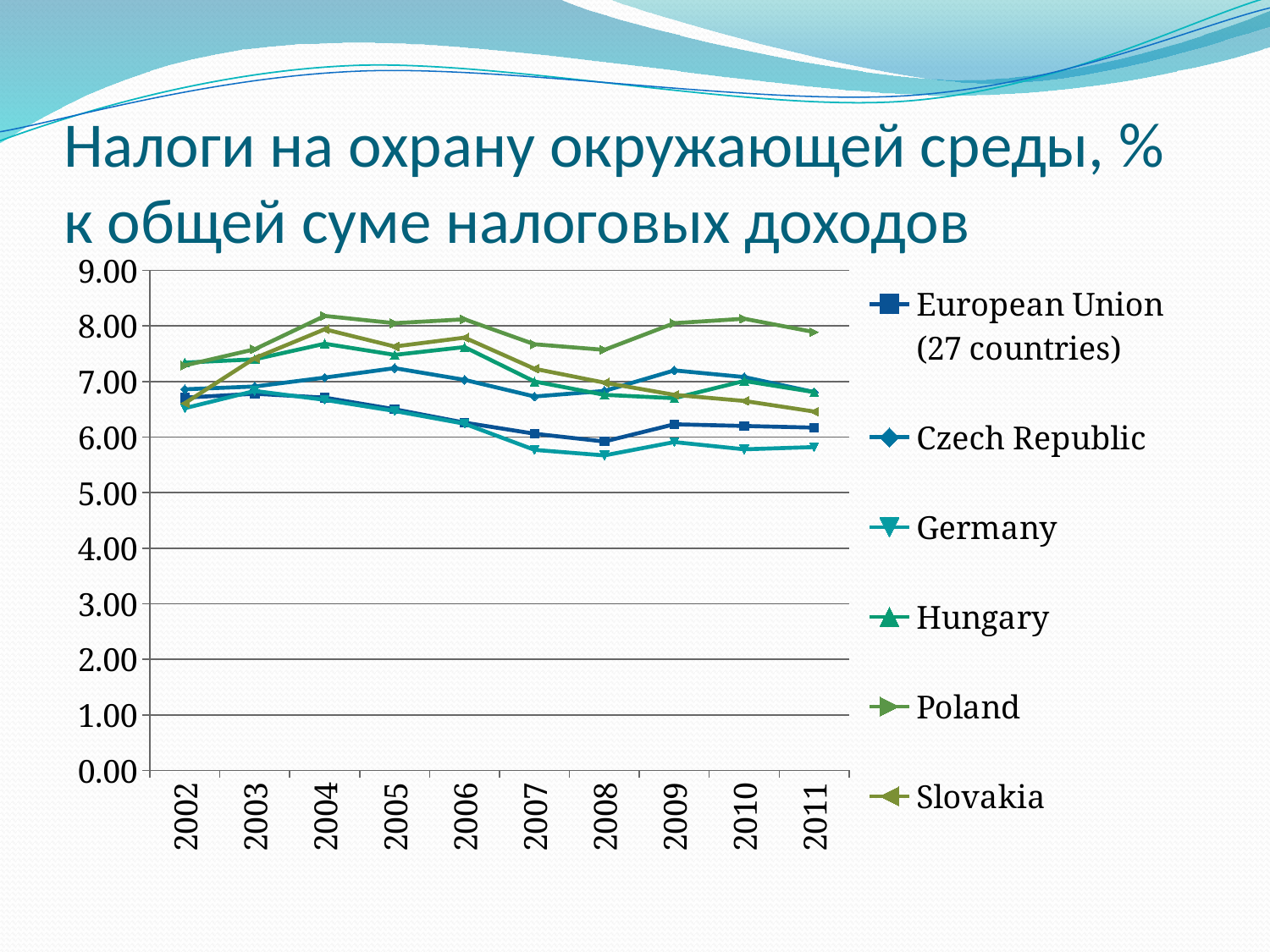
In 2008, which is larger: the value for Poland or the value for Germany? Poland Is the value for Germany in 2008 greater or less than 6.00? less What kind of chart is shown on the slide? line chart Is the value for European Union (27 countries) in 2011 greater or less than 7.00? less Does the value for Germany rise or fall from 2002 to 2011? fall Which series has the highest value in 2011? Poland Is the value for Poland in 2004 greater or less than 8.00? greater Which series is listed first in the legend? European Union (27 countries) How many series does the legend list? 6 How many years are shown on the x axis? 10 Which series has the lowest value in 2011? Germany